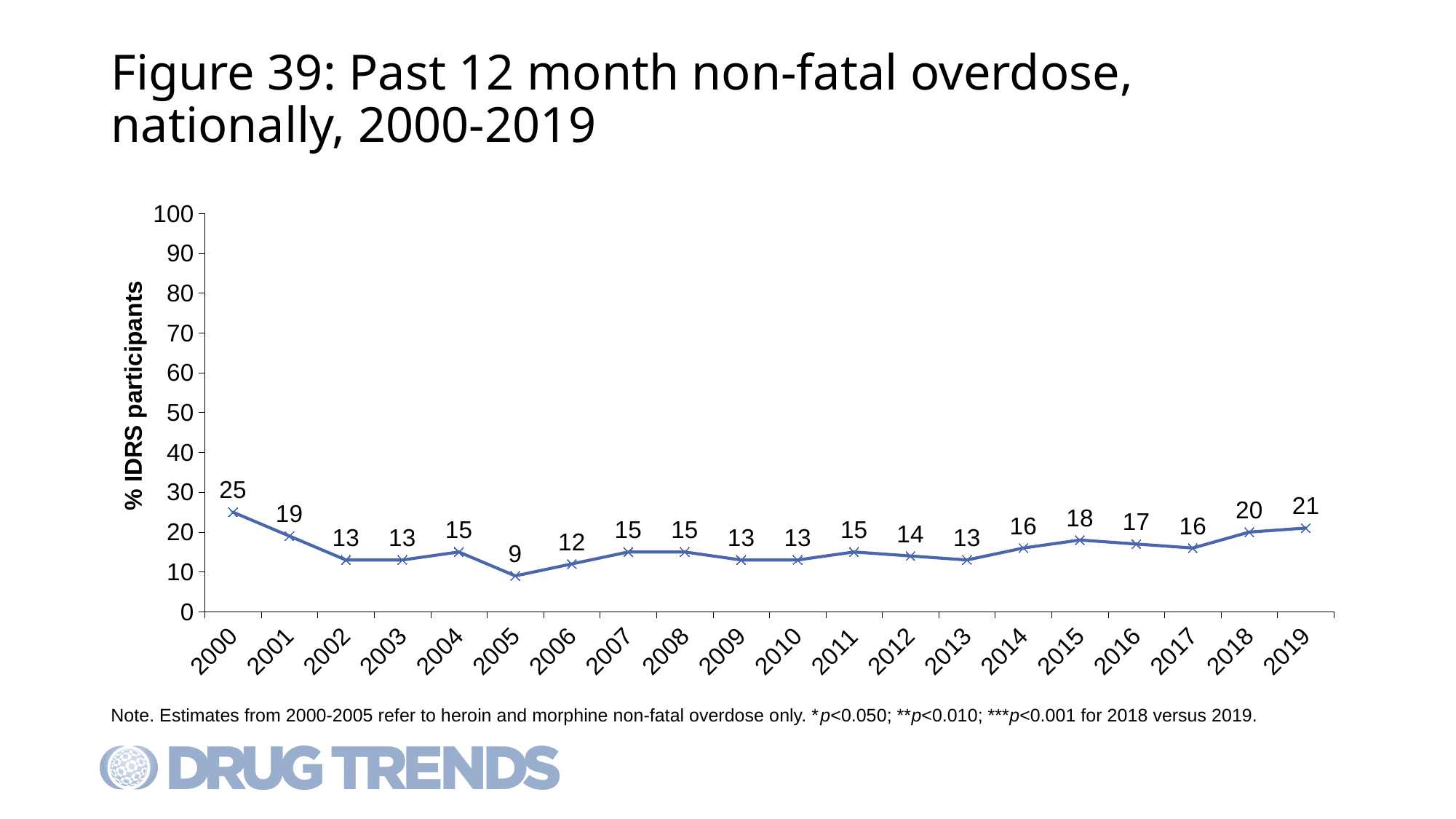
What is the value for 2019? 21 What is the value for 2000? 25 Which is larger, the value for 2001 or the value for 2017? 2001 What is the difference between the values for 2018 and 2019? 1 What is the difference between the values for 2000 and 2019? 4 What kind of chart is shown? line chart Which year has the highest value? 2000 Which year has the lowest value? 2005 How many years are plotted on the chart? 20 What is the label of the y axis? % IDRS participants What is the value for 2005? 9 What is the value for 2015? 18